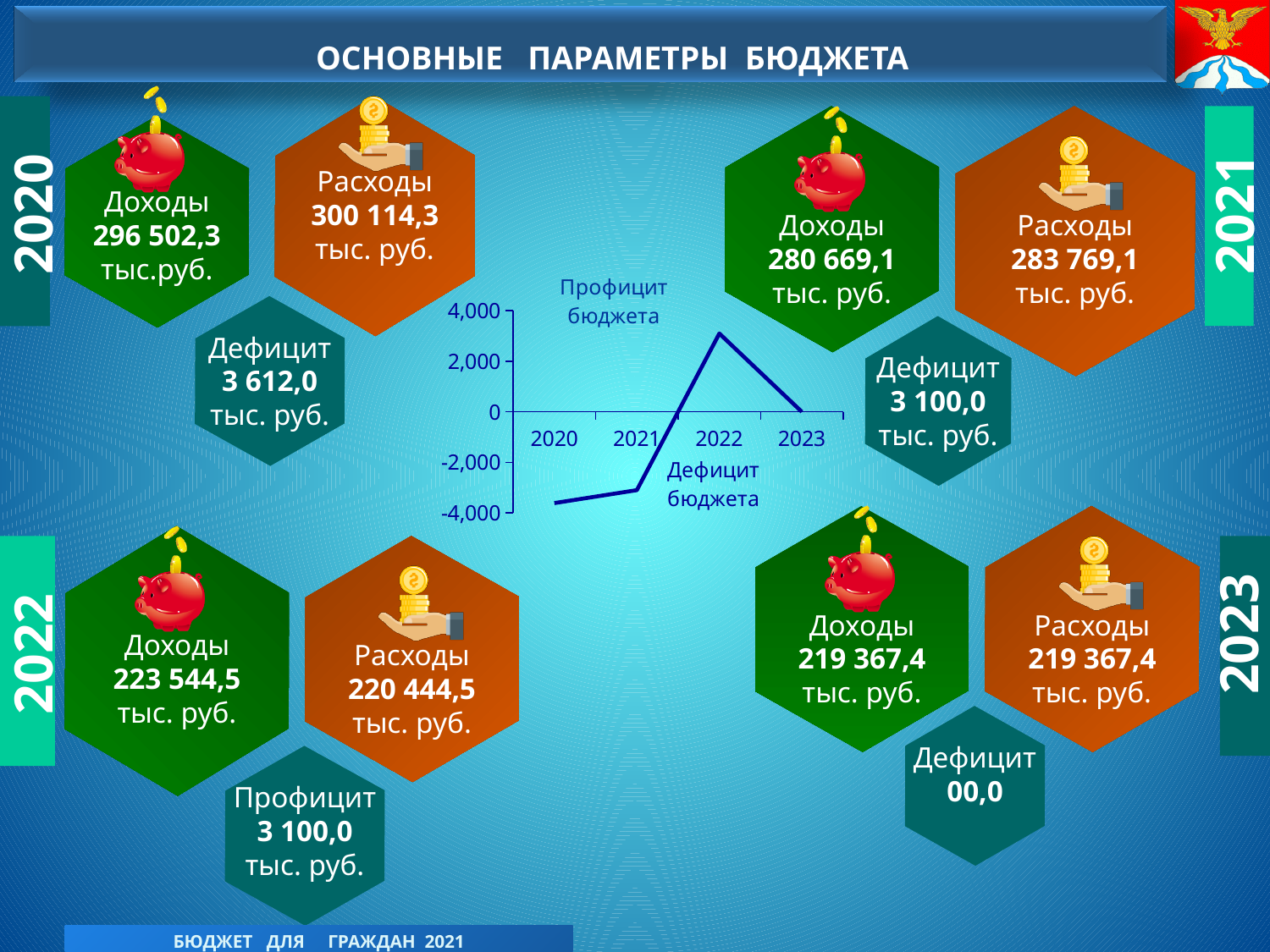
In the line chart, which year has the lowest value? 2020 In the line chart, is the value for 2022 greater or less than 2,000? greater What is the highest tick value shown on the y axis of the line chart? 4,000 In the line chart, does the line rise or fall from 2020 to 2022? rises In the line chart, what value does the line reach in 2023? 0 In the line chart, is the value for 2020 greater or less than -2,000? less In the line chart, which year has the larger value, 2021 or 2022? 2022 In the line chart, which year has the highest value? 2022 In the line chart, which year has the larger value, 2020 or 2021? 2021 How many years are plotted on the x axis of the line chart? 4 In the line chart, is the value for 2021 greater or less than -2,000? less What kind of chart is shown in the centre of the slide? line chart